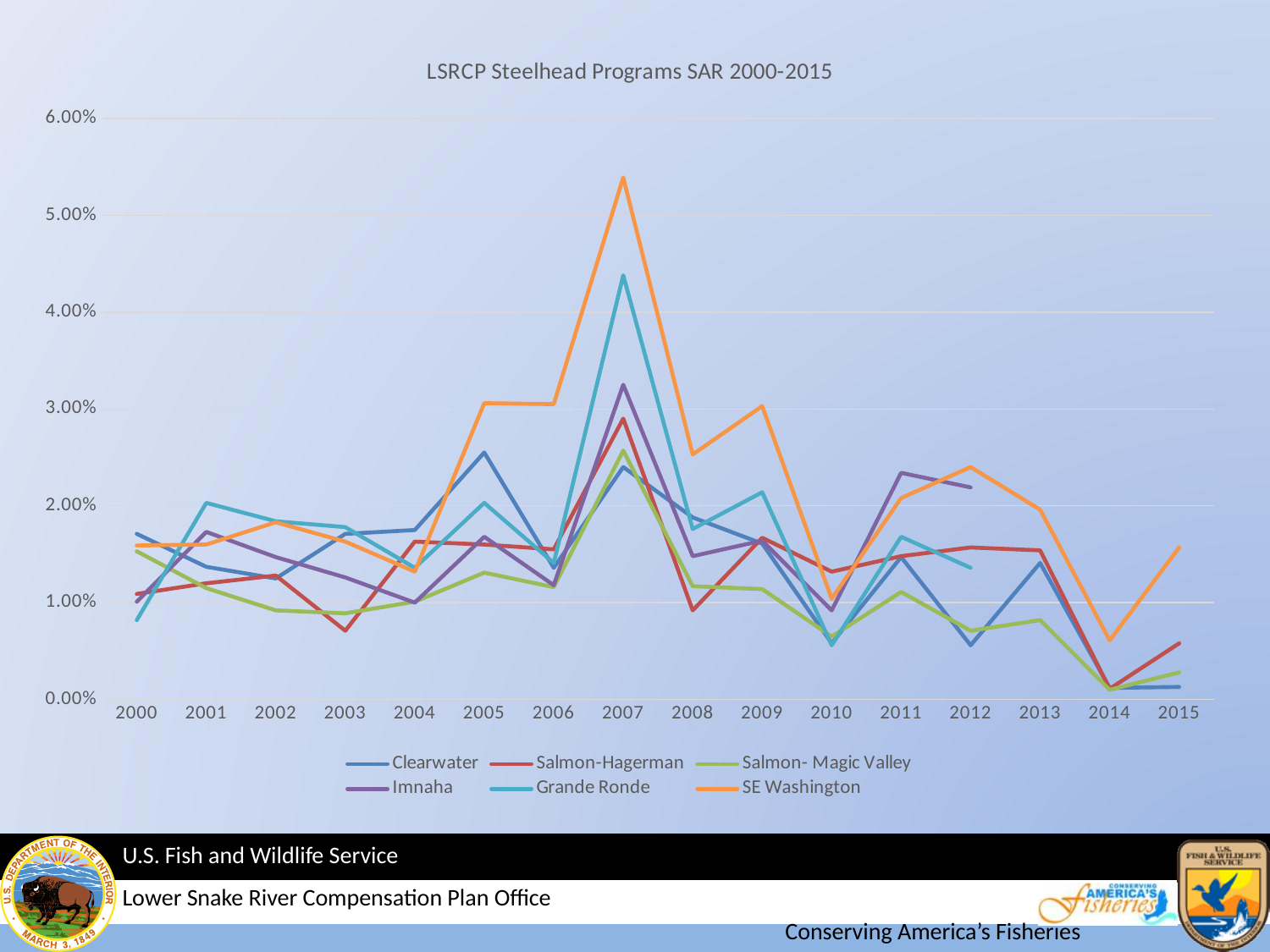
Is the value for SE Washington in 2007 greater or less than 5.00%? greater Is the value for Clearwater in 2005 greater or less than 2.00%? greater Does the SE Washington line rise or fall from 2013 to 2014? fall In 2007, which is larger: SE Washington or Grande Ronde? SE Washington How many years are shown along the x axis? 16 Is the value for Grande Ronde in 2000 greater or less than 1.00%? less What kind of chart is shown on the slide? line chart In which year does SE Washington reach its highest value? 2007 How many series does the legend list? 6 What is the title of the chart? LSRCP Steelhead Programs SAR 2000-2015 Which series has the highest value in 2007? SE Washington